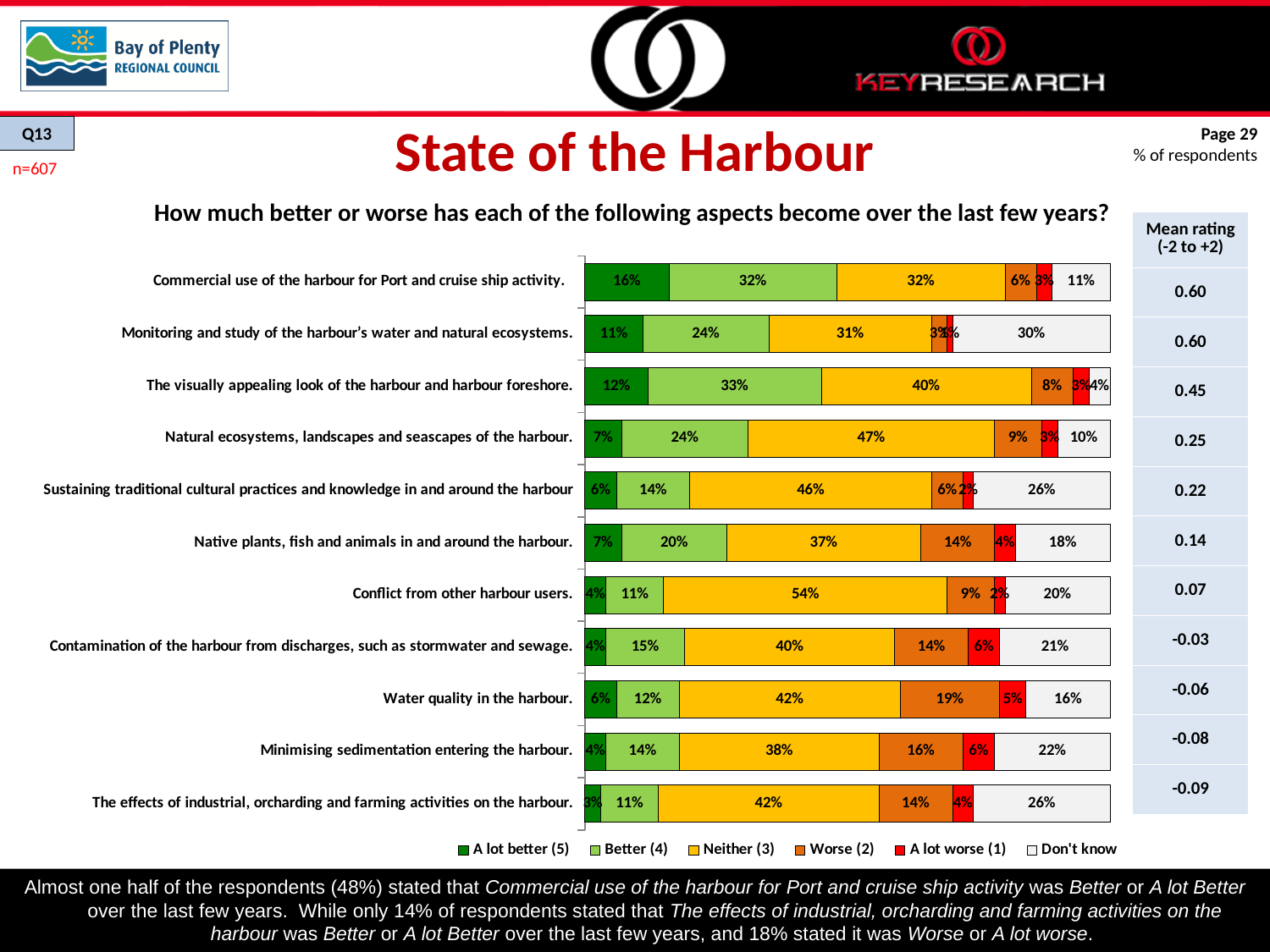
What percentage of respondents said 'Worse (2)' for 'Water quality in the harbour'? 19% What percentage of respondents answered 'Neither (3)' for 'Conflict from other harbour users'? 54% How many aspects (categories) are plotted in the chart? 11 How many series does the chart legend list? 6 What is the 'Don't know' percentage for 'Monitoring and study of the harbour's water and natural ecosystems'? 30% Which aspect has the highest 'A lot better (5)' percentage? Commercial use of the harbour for Port and cruise ship activity What is the first entry in the chart legend? A lot better (5) What is the 'Don't know' percentage for 'Minimising sedimentation entering the harbour'? 22% Which has the larger 'Worse (2)' percentage: 'Contamination of the harbour from discharges, such as stormwater and sewage' or 'Minimising sedimentation entering the harbour'? Minimising sedimentation entering the harbour How many percentage points higher is the 'Better (4)' value for 'Commercial use of the harbour for Port and cruise ship activity' than for 'Water quality in the harbour'? 20 percentage points Which aspect has the highest 'Neither (3)' percentage? Conflict from other harbour users What kind of chart is shown on the slide? Stacked bar chart